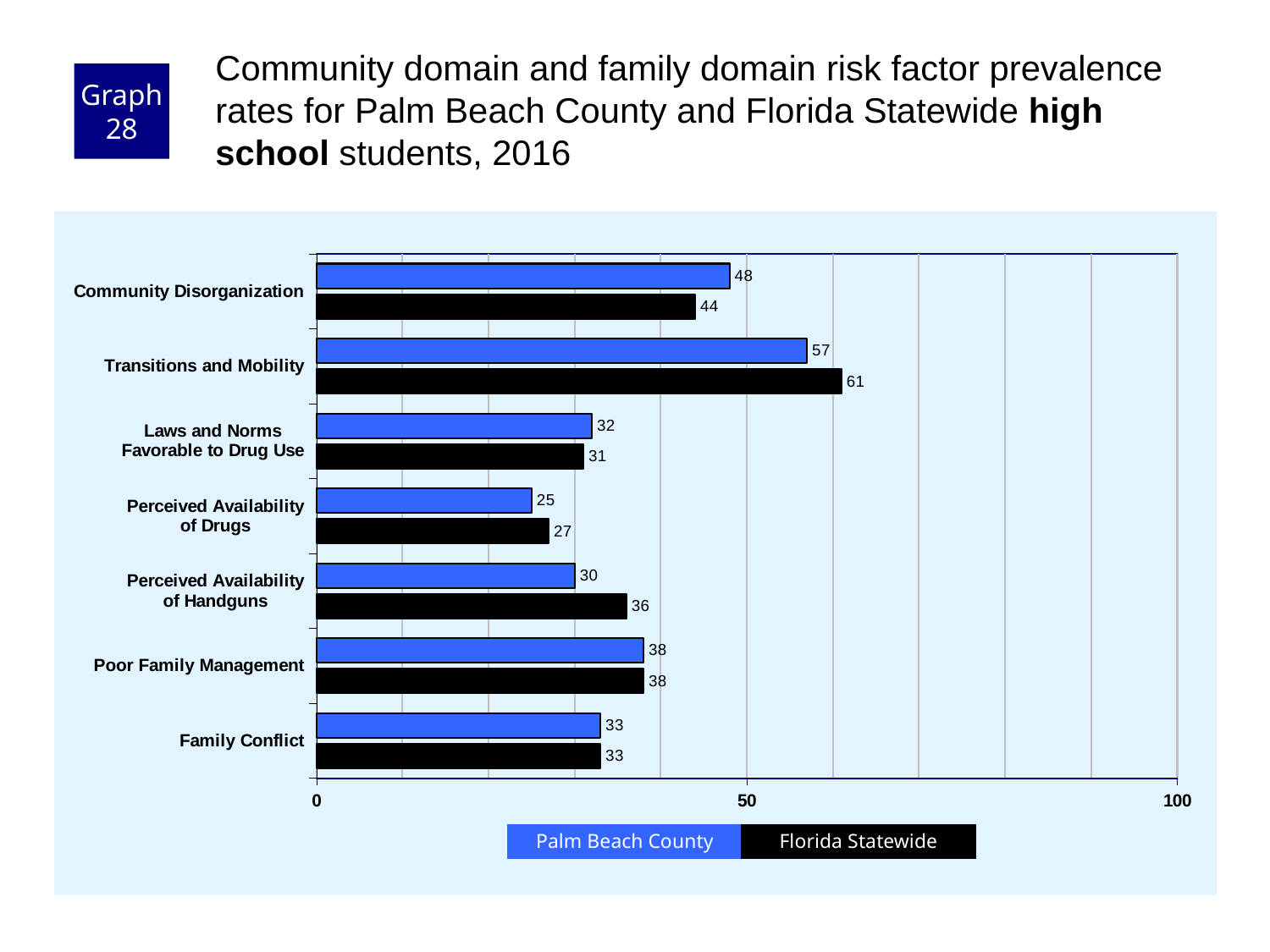
What is the difference between the Florida Statewide and Palm Beach County values for Perceived Availability of Handguns? 6 How many series does the legend list? 2 Which colour represents Florida Statewide in the chart? black What is the Florida Statewide value for Transitions and Mobility? 61 What is the Palm Beach County value for Community Disorganization? 48 Which risk factor has the highest Palm Beach County value? Transitions and Mobility Which is larger for Community Disorganization: the Palm Beach County value or the Florida Statewide value? Palm Beach County Is the Florida Statewide value for Transitions and Mobility greater or less than 50? greater What kind of chart is shown on the slide? bar chart What is the Florida Statewide value for Perceived Availability of Handguns? 36 Which risk factor has the lowest Palm Beach County value? Perceived Availability of Drugs How many risk factor categories are shown on the chart? 7